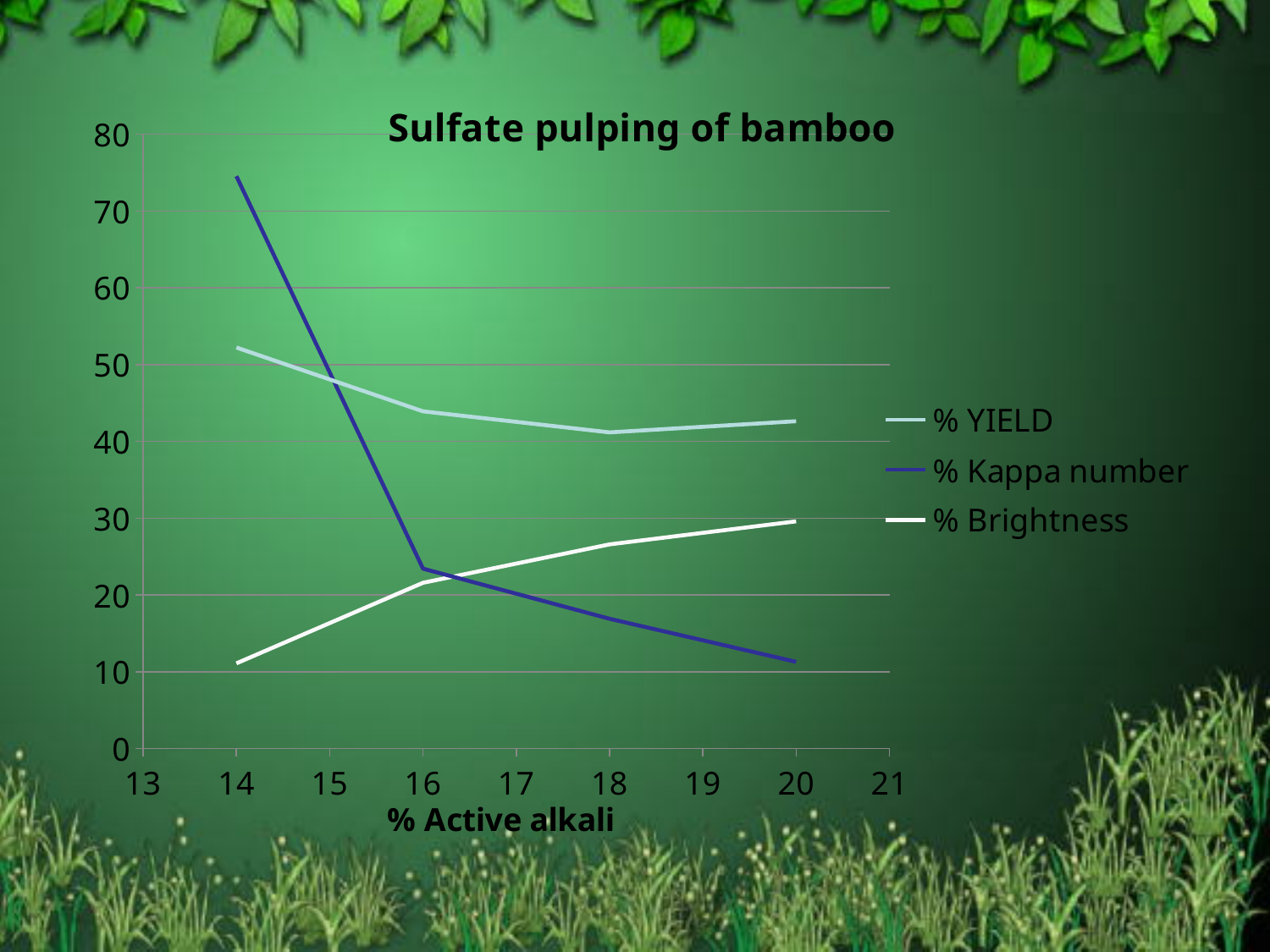
How many series does the legend list? 3 Does the % Kappa number series rise or fall as % Active alkali increases? fall Is the value of % Brightness at 14% active alkali greater or less than 20? less At 14% active alkali, which is larger: % Kappa number or % YIELD? % Kappa number What is the title of the chart? Sulfate pulping of bamboo What is the label of the x axis? % Active alkali How many data points are plotted for the % Kappa number series? 4 Is the value of % Kappa number at 14% active alkali greater or less than 70? greater Does the % Brightness series rise or fall as % Active alkali increases? rise Is the value of % Kappa number at 20% active alkali greater or less than 20? less What kind of chart is shown on the slide? line chart At 18% active alkali, which is larger: % Brightness or % Kappa number? % Brightness